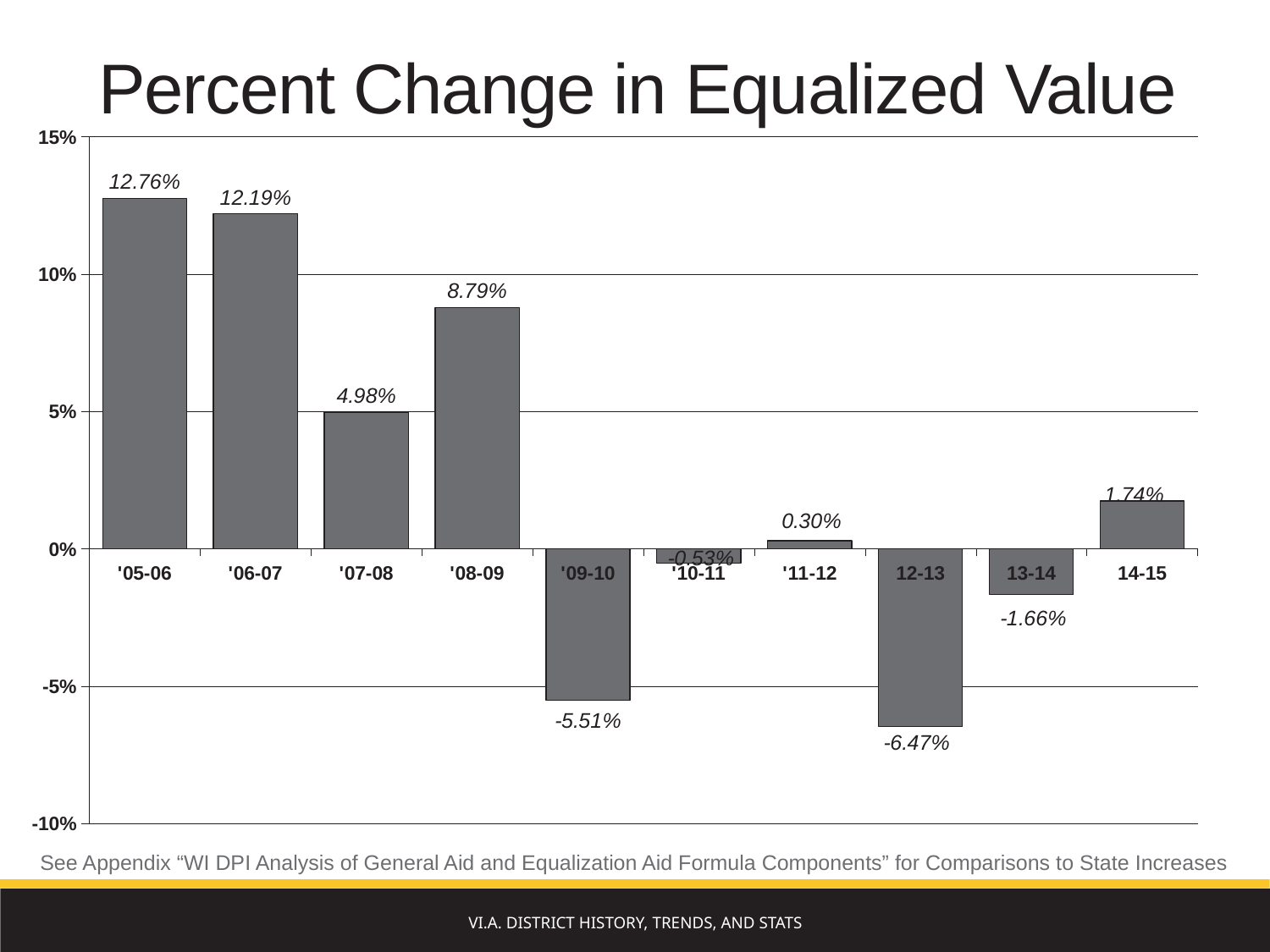
Is the value for '09-10 greater or less than -5%? less Which is larger, the percent change for '07-08 or '08-09? '08-09 Which year has the lowest percent change in equalized value? 12-13 What is the percent change in equalized value for '05-06? 12.76% How many years are shown on the chart? 10 Which year has the highest percent change in equalized value? '05-06 What is the percent change in equalized value for 14-15? 1.74% What is the difference between the percent change for '06-07 and '07-08? 7.21% What is the percent change in equalized value for 12-13? -6.47% What is the percent change in equalized value for '08-09? 8.79% What is the title of the chart? Percent Change in Equalized Value What kind of chart is shown on the slide? Bar chart